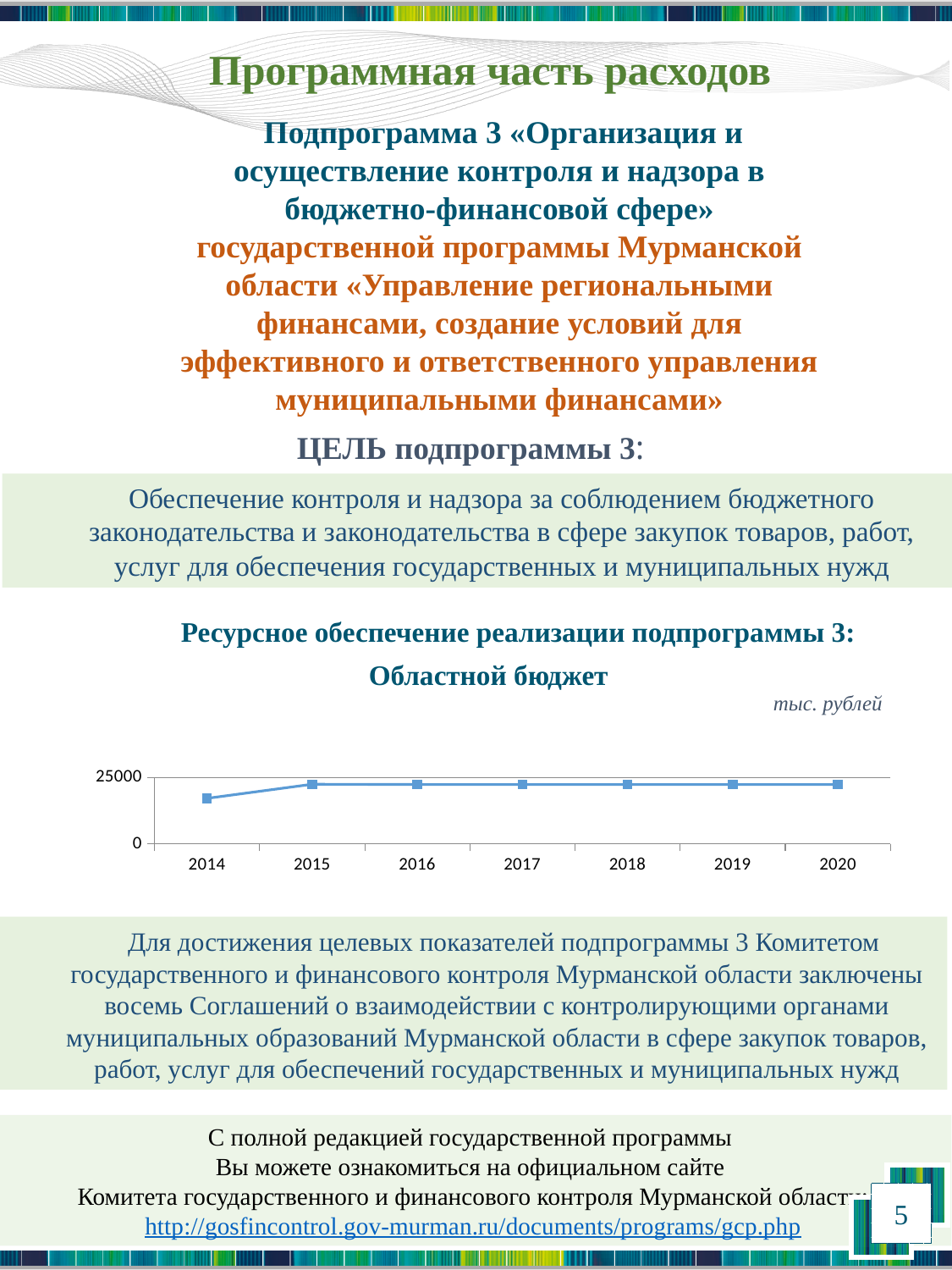
What is the first year shown on the x axis of the chart? 2014 What is the highest tick value shown on the y axis of the chart? 25000 What kind of chart is shown on the slide? line chart Which is larger, the value for 2014 or the value for 2015? 2015 What is the last year shown on the x axis of the chart? 2020 Is the value for 2014 greater or less than 25000? less Does the value rise or fall from 2014 to 2015? rise Which year has the lowest value on the chart? 2014 Is the value for 2020 greater or less than 25000? less How many years (data points) are plotted on the chart? 7